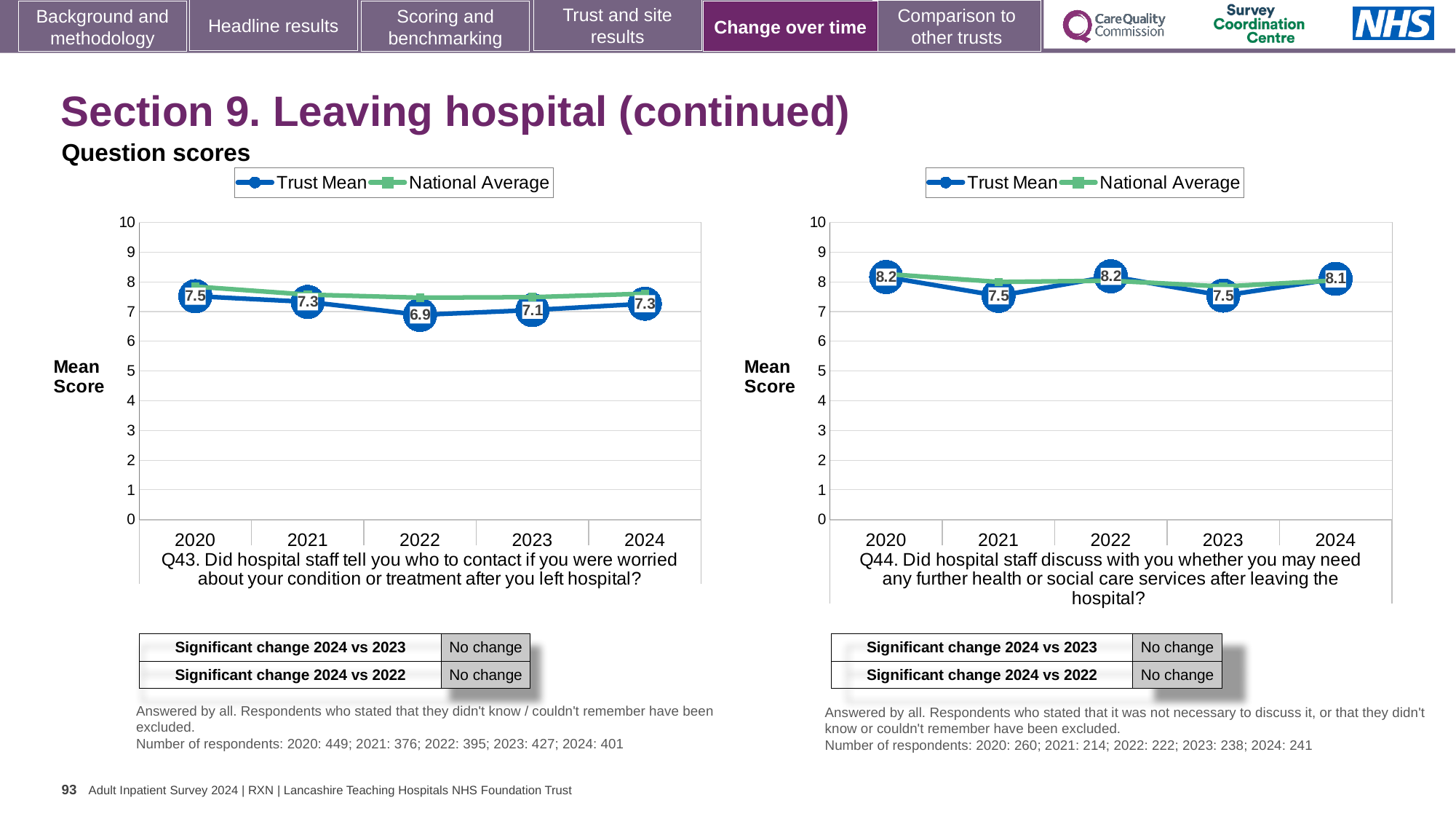
In the Q43 chart on the left, is the National Average for 2022 greater or less than 7? greater How many series does the legend of the Q43 chart on the left list? 2 How many years are shown on the x axis of the Q44 chart on the right? 5 In the Q43 chart on the left, what is the Trust Mean score for 2022? 6.9 What is the label on the y axis of the Q43 chart on the left? Mean Score In the Q44 chart on the right, what is the difference between the Trust Mean scores for 2020 and 2021? 0.7 In the Q43 chart on the left, which year has the highest Trust Mean score? 2020 In the Q43 chart on the left, is the Trust Mean score higher in 2020 or in 2024? 2020 What type of chart is used for Q44 on the right? Line chart In the Q43 chart on the left, does the Trust Mean rise or fall from 2022 to 2024? Rise In the Q44 chart on the right, what is the Trust Mean score for 2024? 8.1 In the Q43 chart on the left, which year has the lowest Trust Mean score? 2022